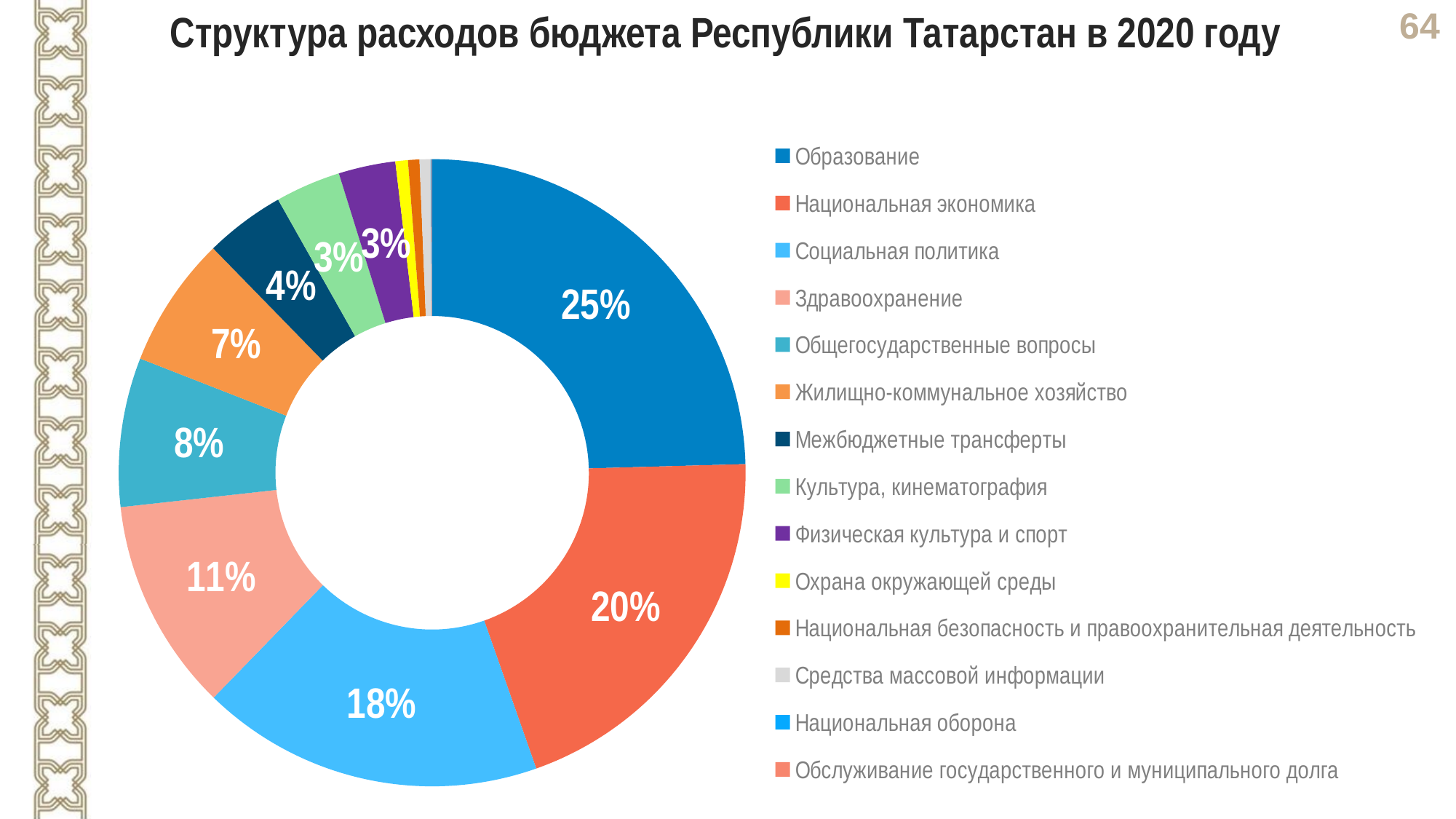
What percentage is shown for Национальная экономика? 20% How many categories does the legend list? 14 What type of chart is shown on the slide? Pie (doughnut) chart Which is larger, the share for Здравоохранение or the share for Общегосударственные вопросы? Здравоохранение What share of the budget expenditure goes to Образование? 25% What percentage is shown for Жилищно-коммунальное хозяйство? 7% Which category has the largest share of the budget expenditure? Образование What percentage does Здравоохранение account for? 11% What is the share for Общегосударственные вопросы? 8% What is the value for Социальная политика? 18% What is the difference in percentage points between Образование and Национальная экономика? 5 What is the value for Межбюджетные трансферты? 4%